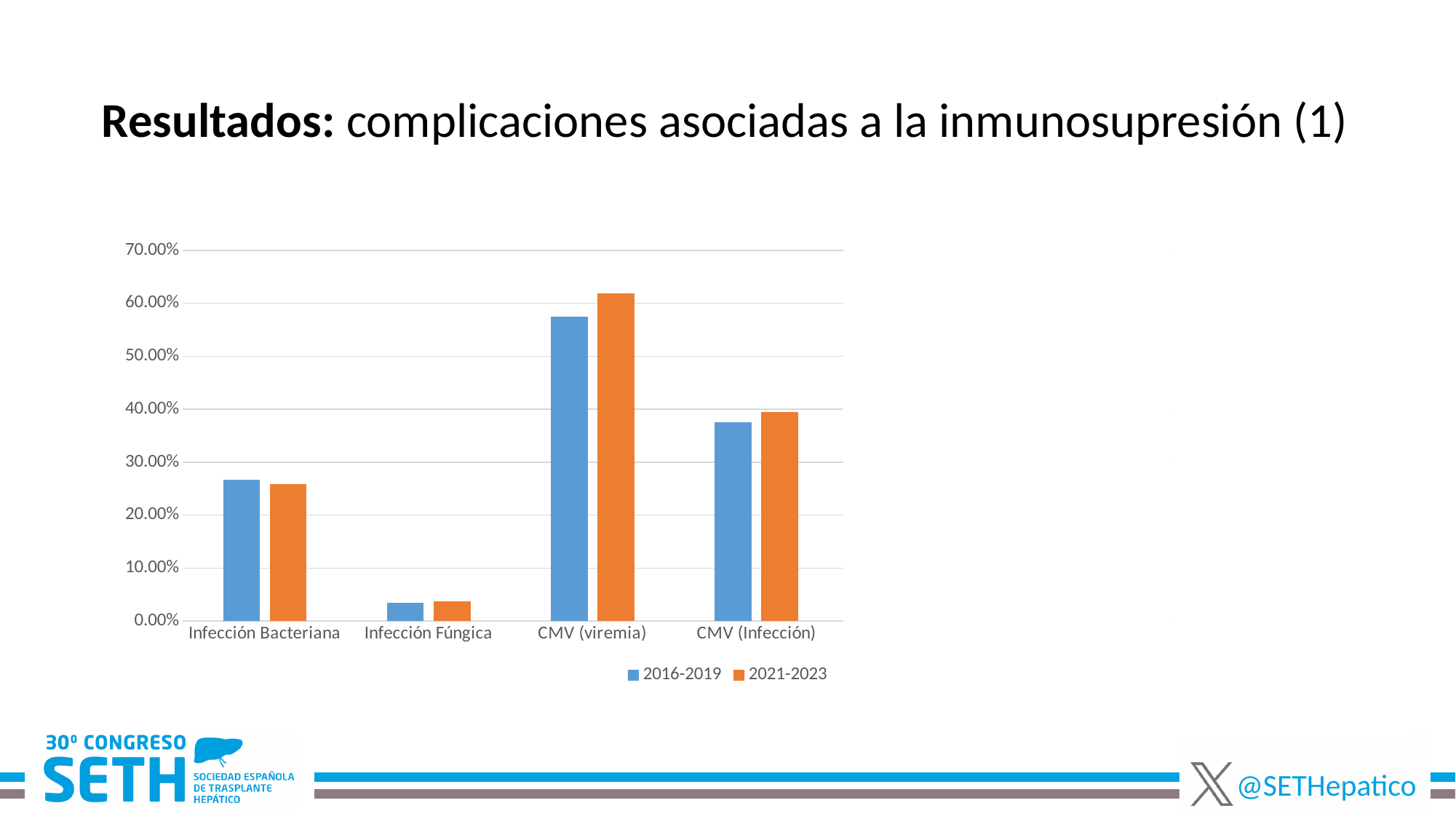
How many categories are shown on the x axis of the chart? 4 What kind of chart is shown on the slide? bar chart Is the 2016-2019 value for CMV (viremia) greater or less than 60.00%? less Is the 2021-2023 value for Infección Fúngica greater or less than 10.00%? less What are the two series named in the chart legend? 2016-2019 and 2021-2023 Which category has the highest value for the 2021-2023 series? CMV (viremia) Is the 2016-2019 value for Infección Bacteriana greater or less than 20.00%? greater Which category has the lowest value for the 2016-2019 series? Infección Fúngica How many series does the chart legend list? 2 For CMV (viremia), which series has the larger value, 2016-2019 or 2021-2023? 2021-2023